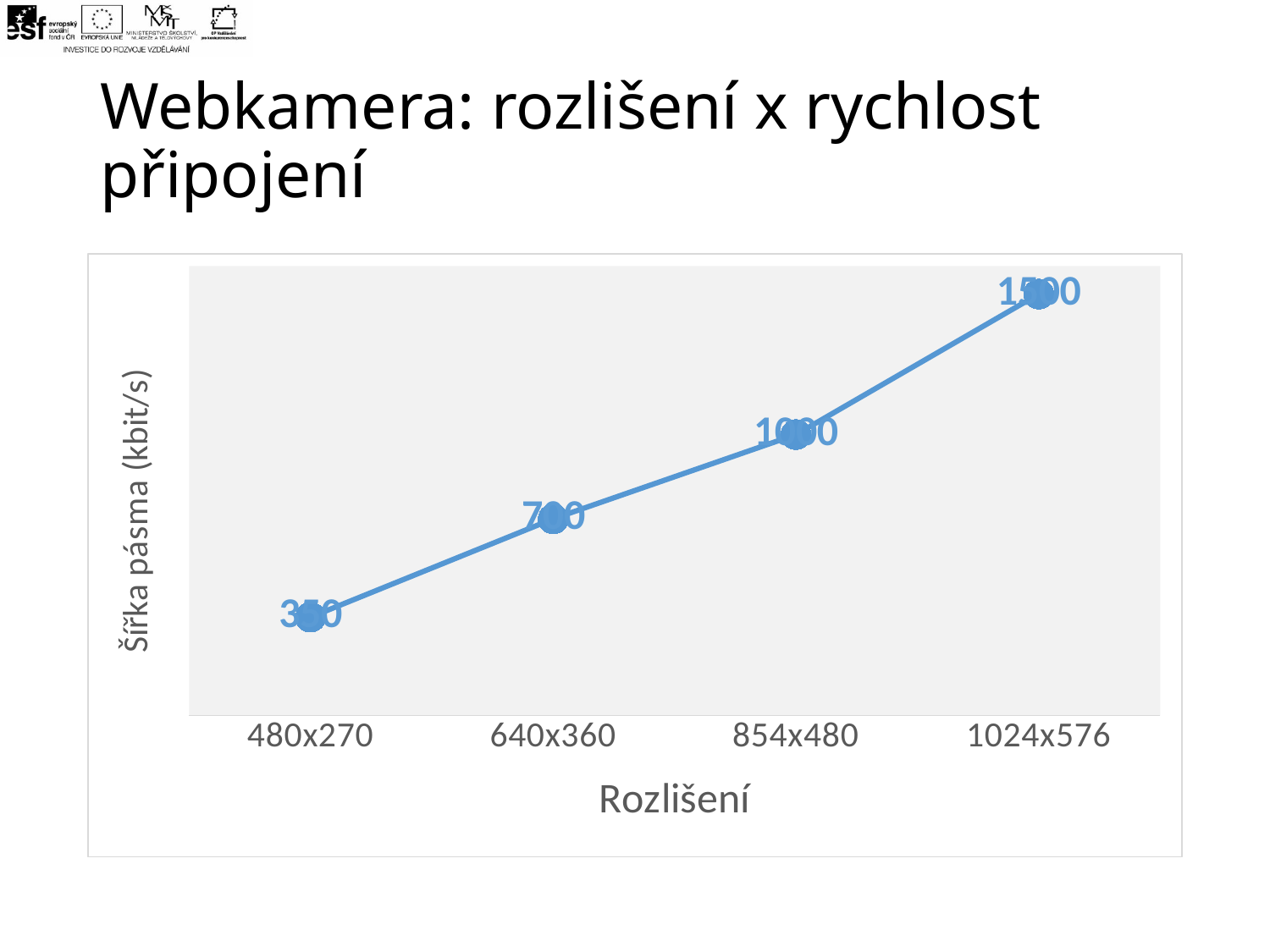
Which resolution has the lowest bandwidth value? 480x270 What is the second category label on the x axis? 640x360 Which has the larger bandwidth value, 640x360 or 854x480? 854x480 What is the title of the y axis? Šířka pásma (kbit/s) Which has the smaller bandwidth value, 480x270 or 1024x576? 480x270 What is the title of the x axis? Rozlišení Which resolution has the highest bandwidth value? 1024x576 How many data points are plotted on the chart? 4 What kind of chart is shown on the slide? line chart Do the values rise or fall as the resolution increases along the x axis? rise